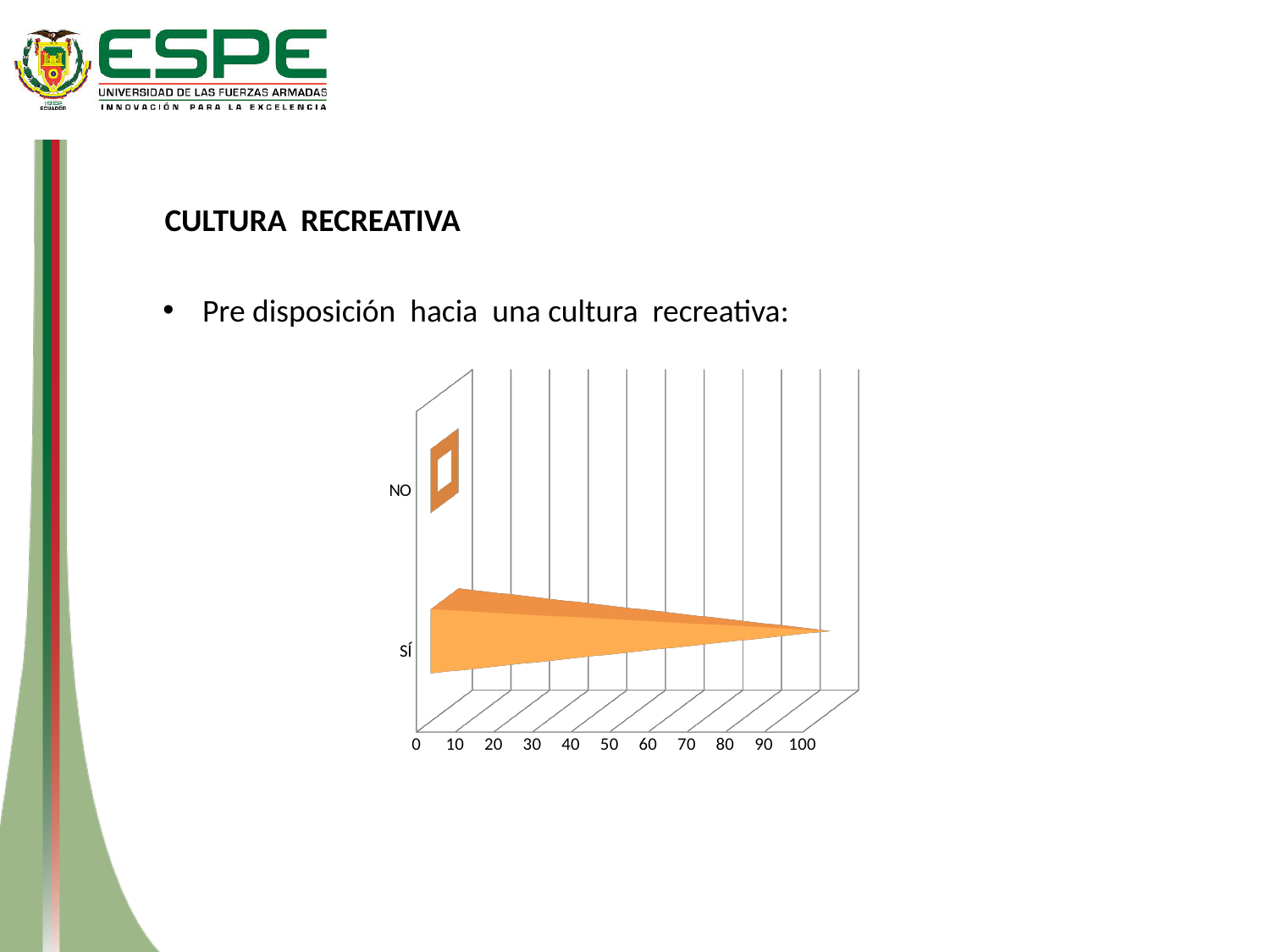
What kind of chart is shown on the slide? bar chart Is the value for SÍ greater or less than 50? greater Which category has the highest value? SÍ Which category has the lowest value? NO Is the value for NO greater or less than 10? less What is the highest tick value shown on the horizontal axis? 100 Which is larger, the value for SÍ or the value for NO? SÍ What are the two category labels on the vertical axis? NO and SÍ How many categories are shown on the chart? 2 Is the value for SÍ greater or less than 90? greater